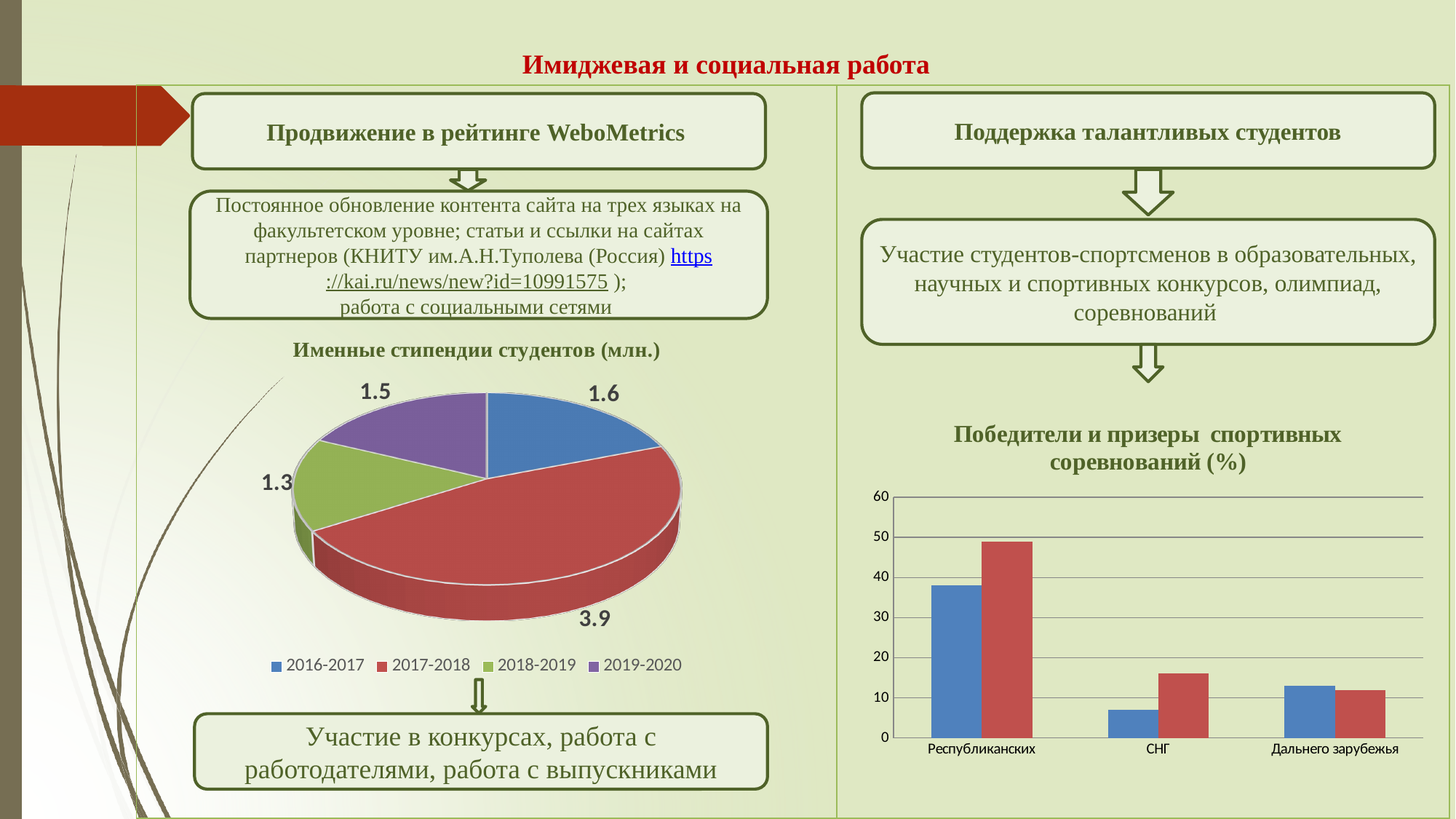
What kind of chart is 'Победители и призеры спортивных соревнований (%)'? Bar chart In the pie chart 'Именные стипендии студентов (млн.)', what is the value for 2017-2018? 3.9 In the pie chart 'Именные стипендии студентов (млн.)', what is the value for 2018-2019? 1.3 In the pie chart 'Именные стипендии студентов (млн.)', which academic year has the largest slice? 2017-2018 How many categories are shown on the x axis of the chart 'Победители и призеры спортивных соревнований (%)'? 3 In the pie chart 'Именные стипендии студентов (млн.)', what is the difference between the values for 2017-2018 and 2016-2017? 2.3 How many entries does the legend of the pie chart 'Именные стипендии студентов (млн.)' list? 4 In the pie chart 'Именные стипендии студентов (млн.)', which academic year has the smallest slice? 2018-2019 In the chart 'Победители и призеры спортивных соревнований (%)', is the red bar for Республиканских greater or less than 40? greater In the pie chart 'Именные стипендии студентов (млн.)', what is the sum of all four slice values? 8.3 In the pie chart 'Именные стипендии студентов (млн.)', which colour represents 2019-2020? Purple In the chart 'Победители и призеры спортивных соревнований (%)', which bar is taller for СНГ, the blue one or the red one? The red one